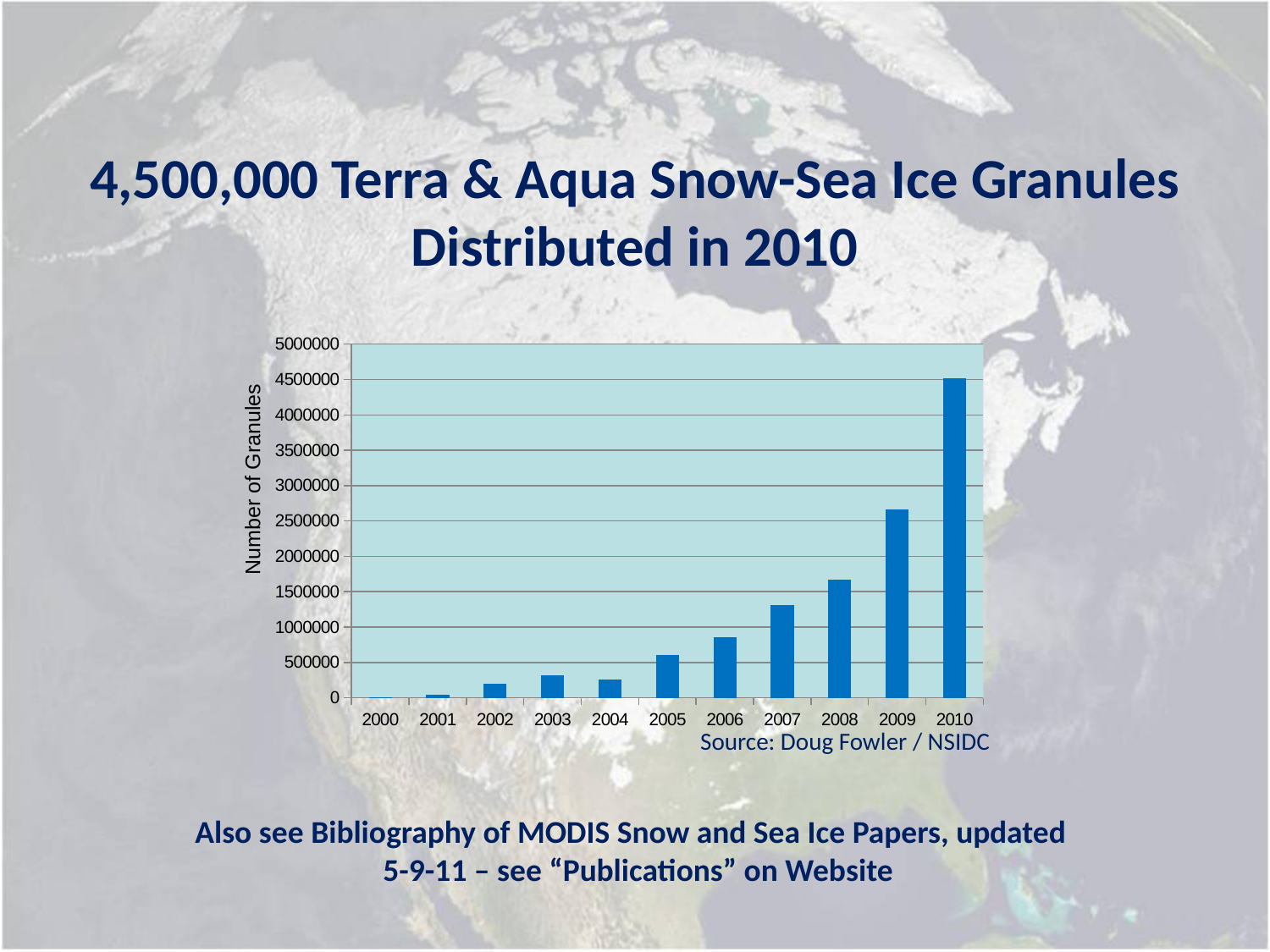
Is the value for 2009 greater or less than 2000000? greater Which year has more granules, 2008 or 2009? 2009 What is the title of the chart's y axis? Number of Granules What kind of chart is shown on the slide? bar chart Is the value for 2007 greater or less than 1000000? greater Which year has the highest number of granules? 2010 How many years are plotted on the x axis of the chart? 11 Is the value for 2006 greater or less than 1000000? less Which year has the lowest number of granules? 2000 Do the number of granules generally rise or fall from 2000 to 2010? rise